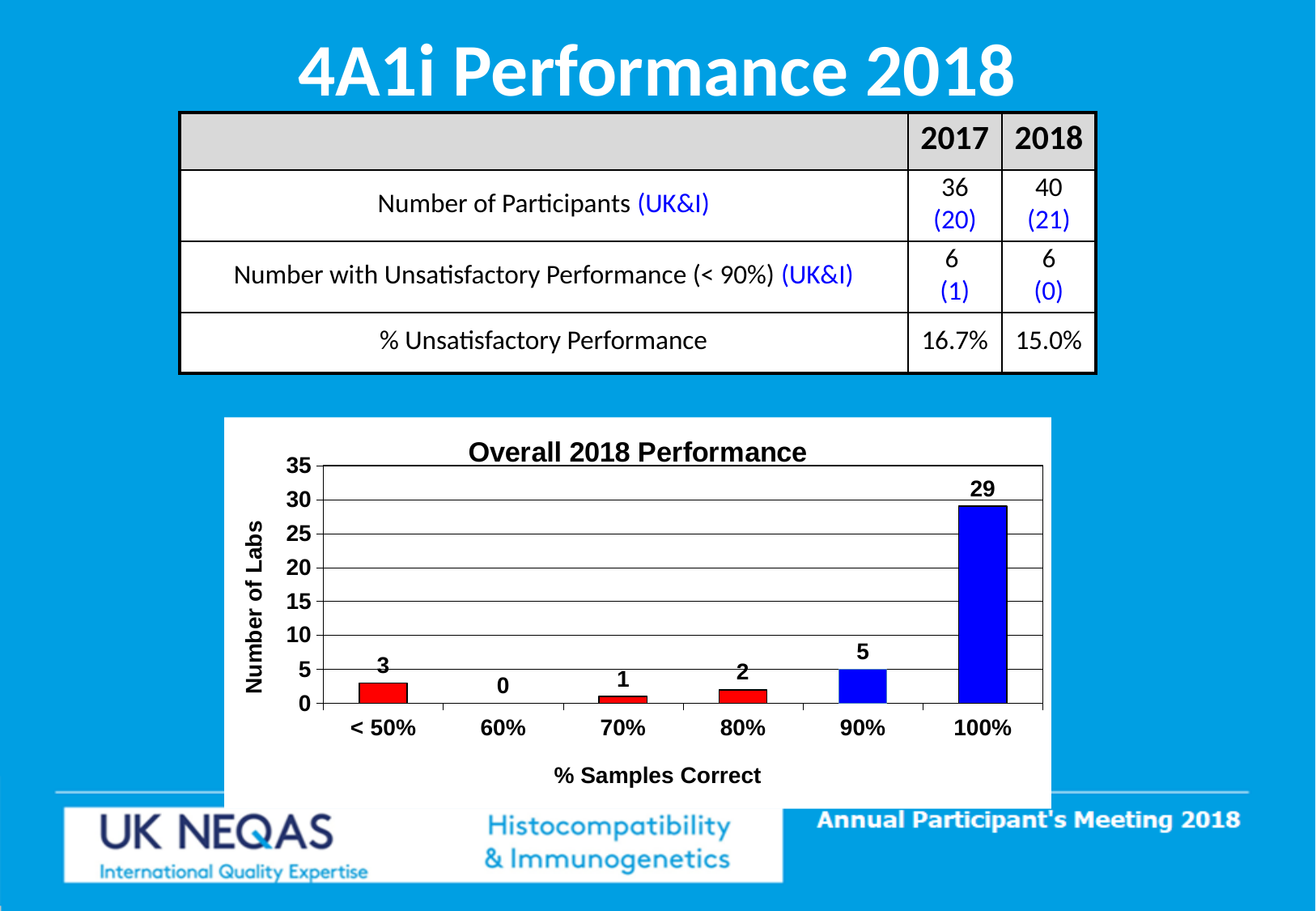
Is the value for 100% greater or less than 25? greater What kind of chart is shown? bar chart Which category has the highest number of labs? 100% Which category has the lowest number of labs? 60% What is the title of the chart? Overall 2018 Performance What is the number of labs for the 90% category? 5 What is the difference in number of labs between the 100% and 90% categories? 24 What is the number of labs for the 60% category? 0 What is the number of labs for the < 50% category? 3 Which has more labs, the 80% category or the < 50% category? < 50% How many categories are shown on the x axis? 6 What is the number of labs for the 100% category? 29